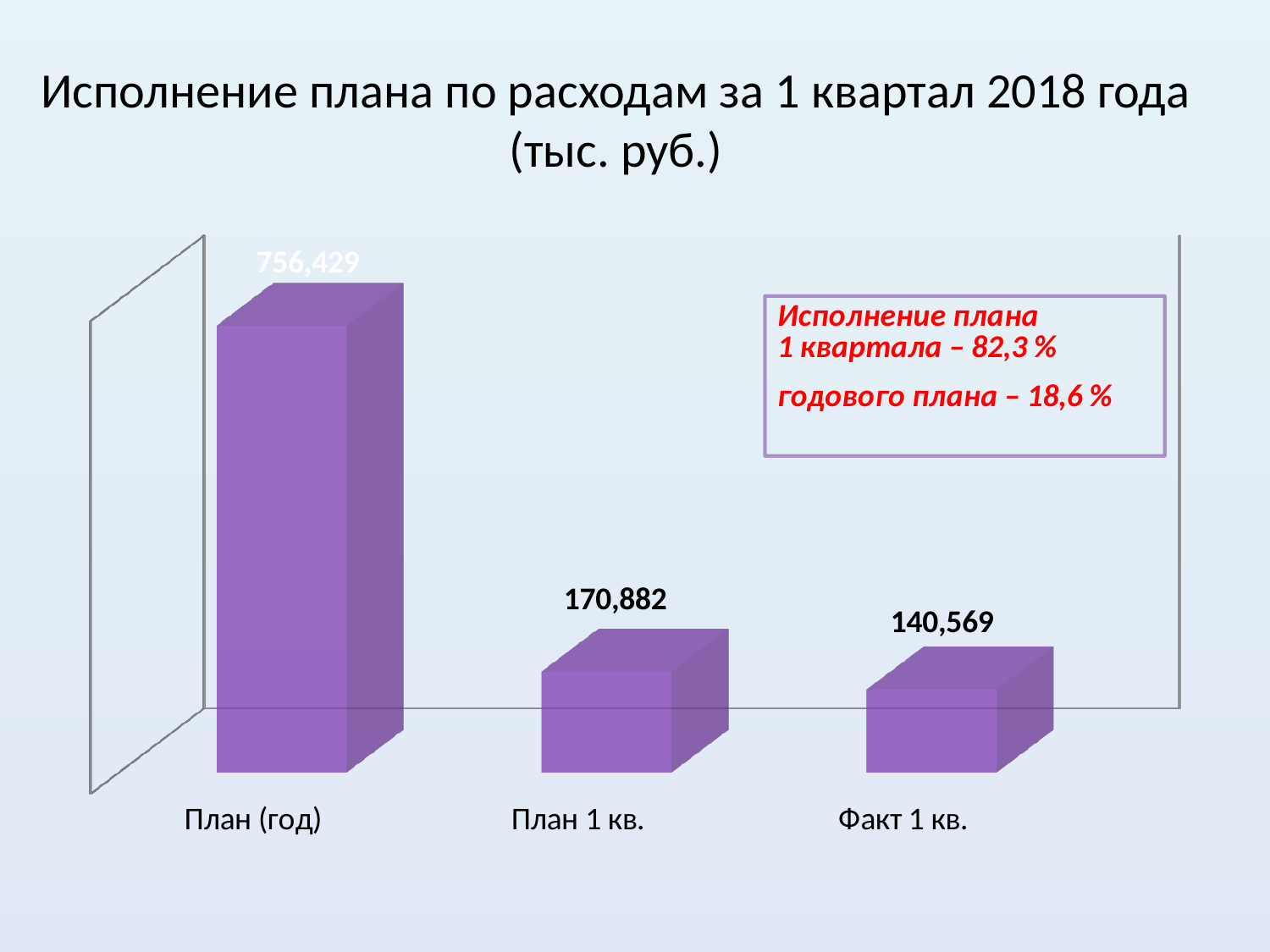
Which is larger, План 1 кв. or Факт 1 кв.? План 1 кв. What is the title of the chart on the slide? Исполнение плана по расходам за 1 квартал 2018 года (тыс. руб.) What kind of chart is shown on the slide? Bar chart How many categories are shown in the chart? 3 What is the value for План 1 кв.? 170,882 What is the difference between План (год) and План 1 кв.? 585,547 What is the value for Факт 1 кв.? 140,569 Which category has the highest value? План (год) What is the difference between План 1 кв. and Факт 1 кв.? 30,313 What is the value for План (год)? 756,429 Do the values rise or fall from left to right across the categories? Fall Which category has the lowest value? Факт 1 кв.